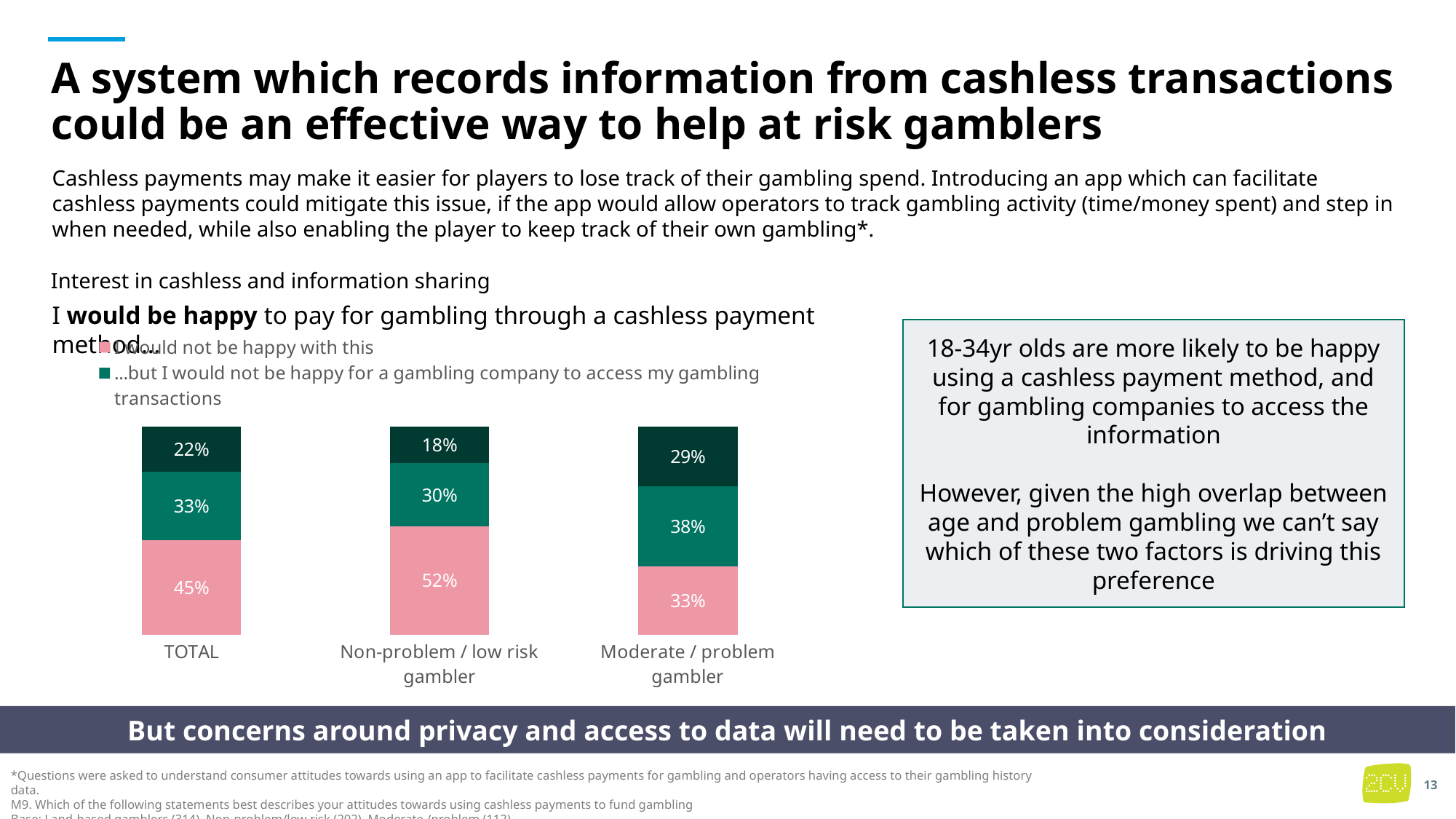
What is the difference between the top (dark green) segment for Moderate / problem gambler and for TOTAL? 7 percentage points What is the value of the bottom (pink) segment for the TOTAL bar? 45% Which category has the largest bottom (pink) segment? Non-problem / low risk gambler How many categories (bars) are shown in the chart? 3 What type of chart is shown on the slide? Stacked bar chart What is the value of the top (dark green) segment for Non-problem / low risk gambler? 18% Which is larger: the '...but I would not be happy for a gambling company to access my gambling transactions' value for TOTAL or for Moderate / problem gambler? Moderate / problem gambler What percentage of Moderate / problem gamblers chose '...but I would not be happy for a gambling company to access my gambling transactions'? 38% What colour represents '...but I would not be happy for a gambling company to access my gambling transactions' in the legend? Green What is the total of the three segments in the TOTAL bar? 100% Which category has the smallest top (dark green) segment? Non-problem / low risk gambler What is the difference between the pink segment for Non-problem / low risk gambler and the pink segment for Moderate / problem gambler? 19 percentage points